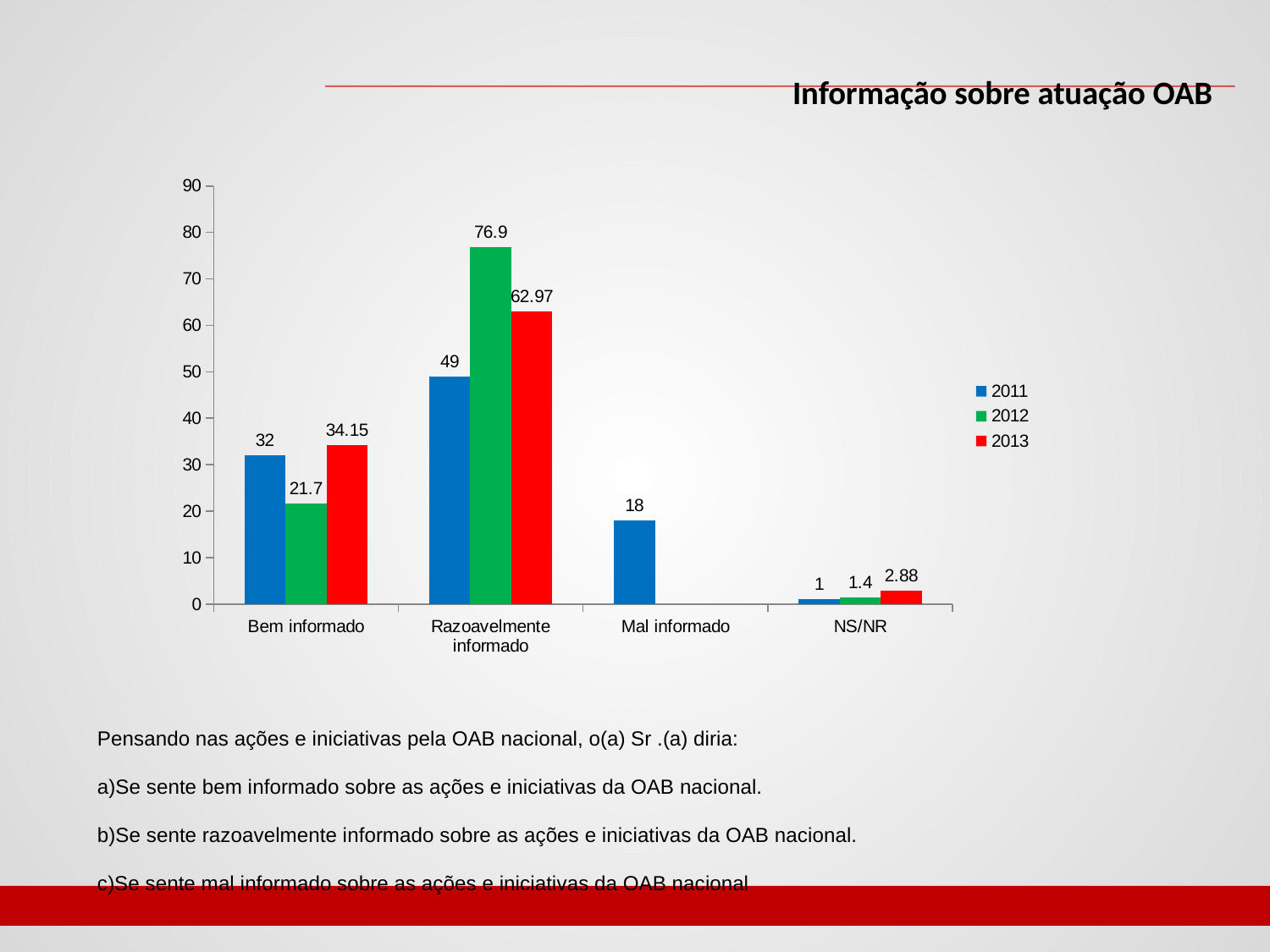
What kind of chart is shown on the slide? Bar chart What is the value for 2013 in the "Bem informado" category? 34.15 Is the 2013 value for "Razoavelmente informado" greater or less than 60? greater What is the value for 2012 in the "Razoavelmente informado" category? 76.9 Which category has the lowest value for the 2012 series? NS/NR Which is larger in the "Bem informado" category: the 2011 value or the 2012 value? 2011 What is the difference between the 2012 and 2011 values in the "Razoavelmente informado" category? 27.9 How many categories are shown on the x axis? 4 Which category has the highest value for the 2011 series? Razoavelmente informado How many series does the legend list? 3 What is the value for 2011 in the "Mal informado" category? 18 What is the value for 2013 in the "NS/NR" category? 2.88